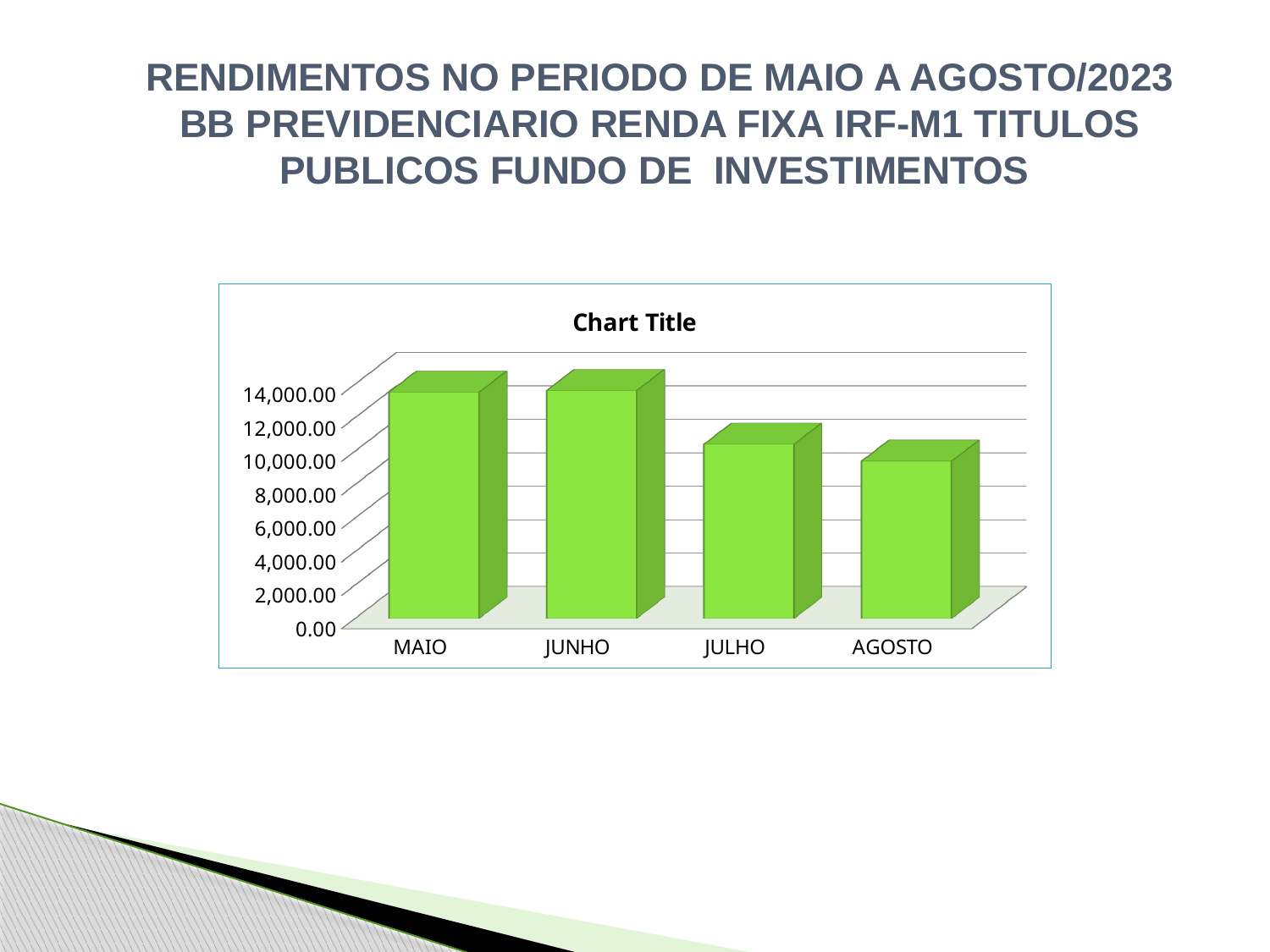
What colour are the bars in the chart? green What kind of chart is shown on the slide? bar chart Which is larger, the value for JULHO or the value for AGOSTO? JULHO What is the title printed above the chart's plot area? Chart Title Which is larger, the value for MAIO or the value for JULHO? MAIO Do the values rise or fall from MAIO to AGOSTO along the x axis? fall Is the value for AGOSTO greater or less than 8,000.00? greater How many categories (months) are shown on the x axis of the chart? 4 Which month has the lowest value in the chart? AGOSTO Is the value for JULHO greater or less than 12,000.00? less Is the value for JUNHO greater or less than 10,000.00? greater